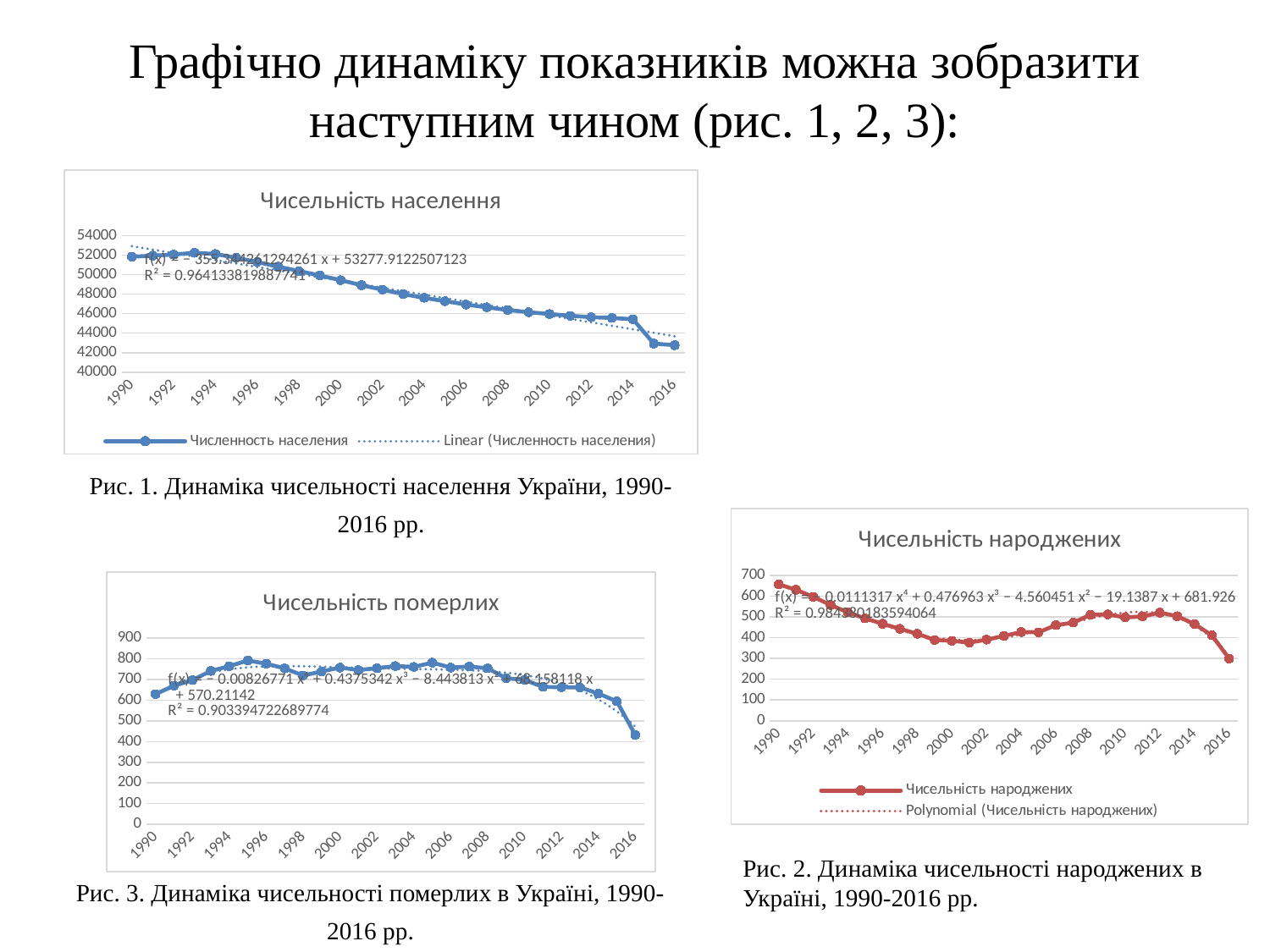
What is the title of the chart at the top left of the slide? Чисельність населення In the "Чисельність народжених" chart, which year has the highest value? 1990 In the "Чисельність померлих" chart, is the value for 2016 greater or less than 500? less In the "Чисельність народжених" chart, is the value for 2016 greater or less than 400? less In the "Чисельність померлих" chart, which year has the lowest value? 2016 How many entries does the legend of the "Чисельність народжених" chart list? 2 What kind of chart is the "Чисельність населення" chart? line chart In the "Чисельність населення" chart, which is larger, the value for 1990 or the value for 2016? 1990 In the "Чисельність населення" chart, is the value for 1990 greater or less than 50000? greater In the "Чисельність народжених" chart, which year has the lowest value? 2016 In the "Чисельність населення" chart, do the values generally rise or fall from 1990 to 2016? fall